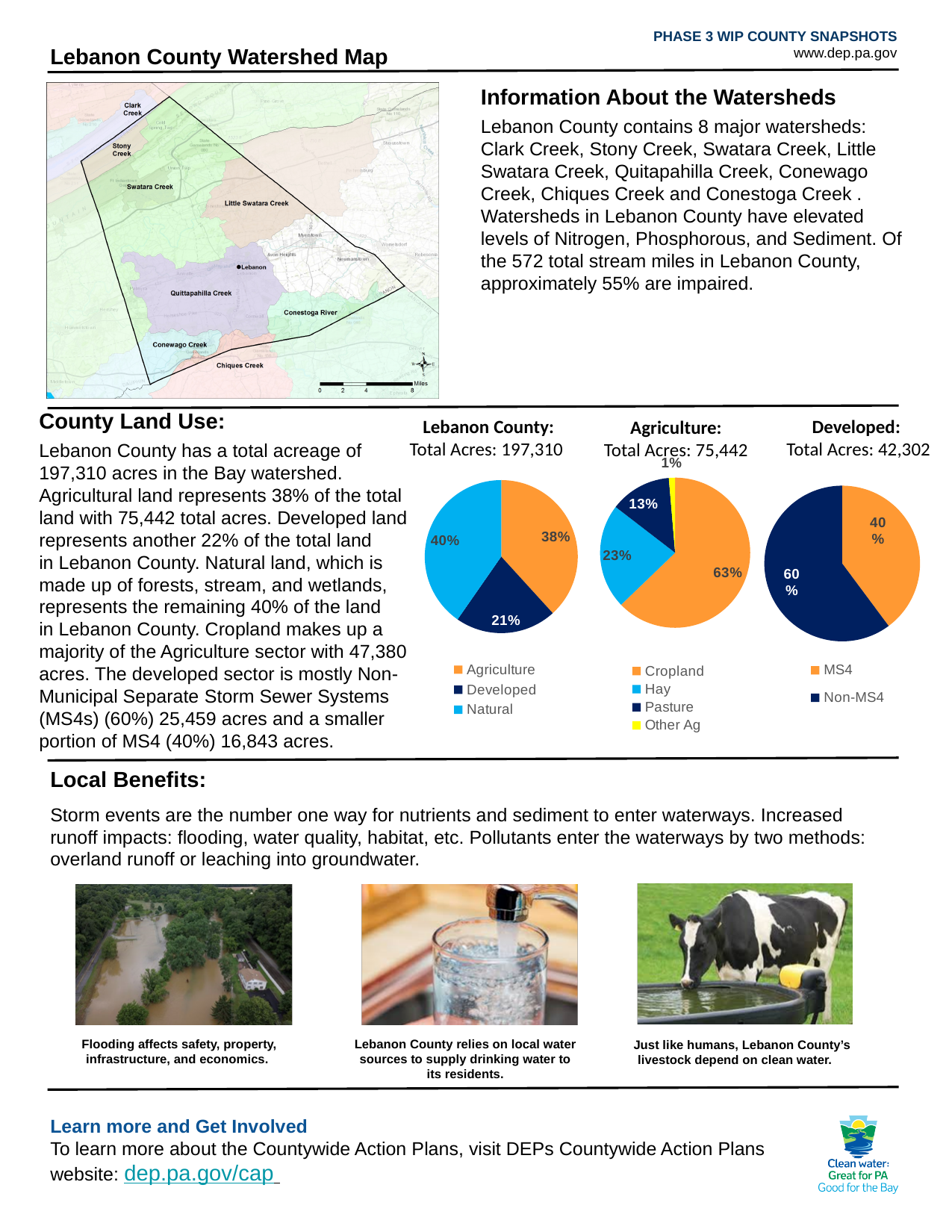
In the Agriculture pie chart, what is the difference between the Cropland and Pasture shares? 50% In the Lebanon County pie chart, what share of land is Natural? 40% How many categories does the Agriculture pie chart's legend list? 4 In the Lebanon County pie chart, which category has the smallest share? Developed In the Developed pie chart, what share is Non-MS4? 60% In the Agriculture pie chart, what share is Hay? 23% In the Agriculture pie chart, which category has the smallest share? Other Ag In the Agriculture pie chart, what share is Cropland? 63% In the Developed pie chart, which is larger, MS4 or Non-MS4? Non-MS4 In the Lebanon County pie chart, what share of land is Developed? 21% In the Lebanon County pie chart, which category has the largest share? Natural What type of chart is used for the Developed land use breakdown? Pie chart